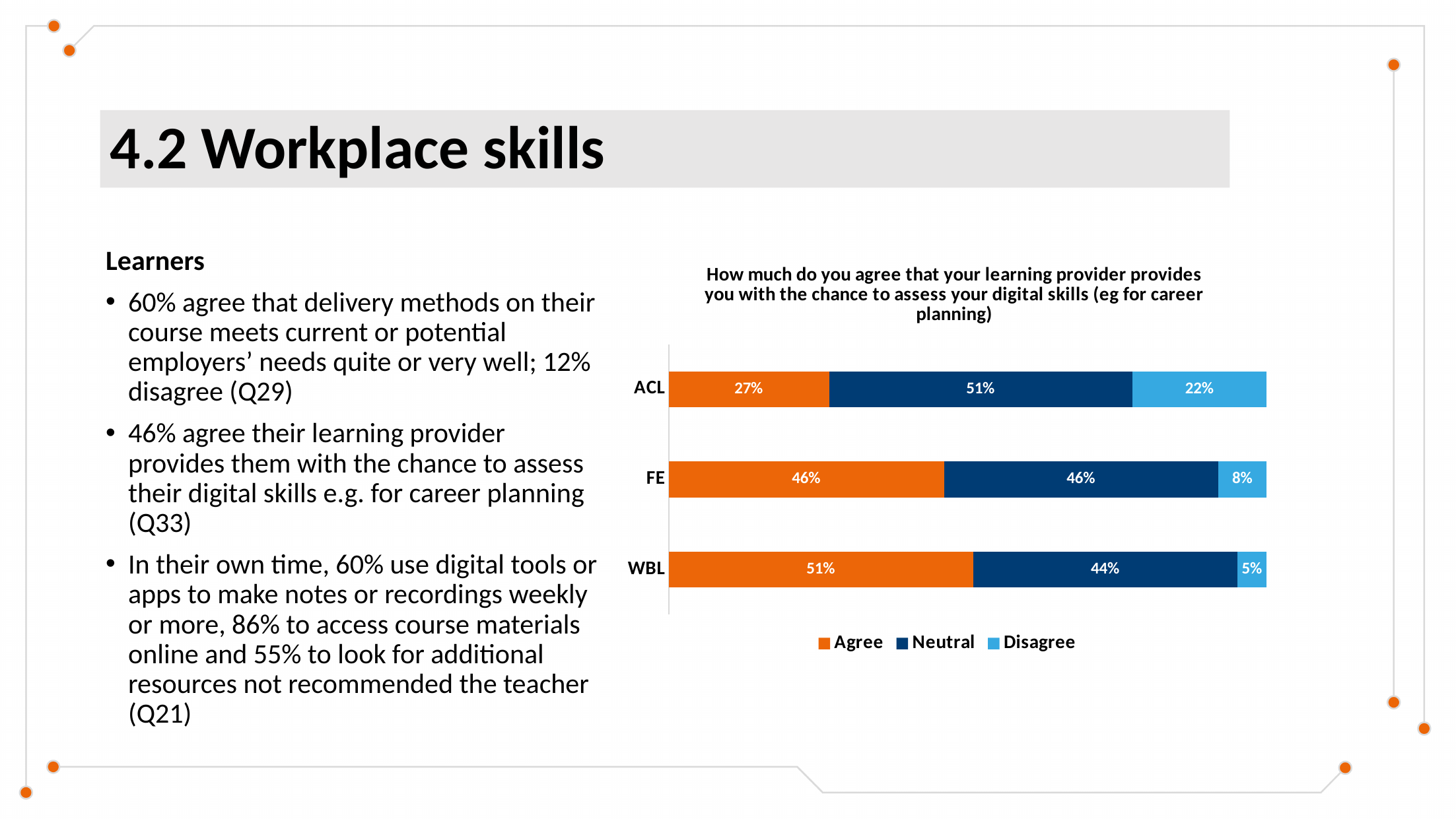
Which category has the lowest Disagree value in the chart? WBL What percentage of ACL learners agree that their learning provider gives them the chance to assess their digital skills? 27% What is the total of the three segments in the ACL bar? 100% How many series does the chart's legend list? 3 Which category has the highest Agree value in the chart? WBL What is the difference between the Agree values for WBL and ACL? 24% What is the Neutral value for FE in the chart? 46% How many categories are shown on the chart's vertical axis? 3 Which series is shown in orange in the chart? Agree What is the Disagree value for WBL in the chart? 5% What kind of chart is shown on the slide? Stacked bar chart Which is larger: the Disagree value for ACL or the Disagree value for FE? ACL